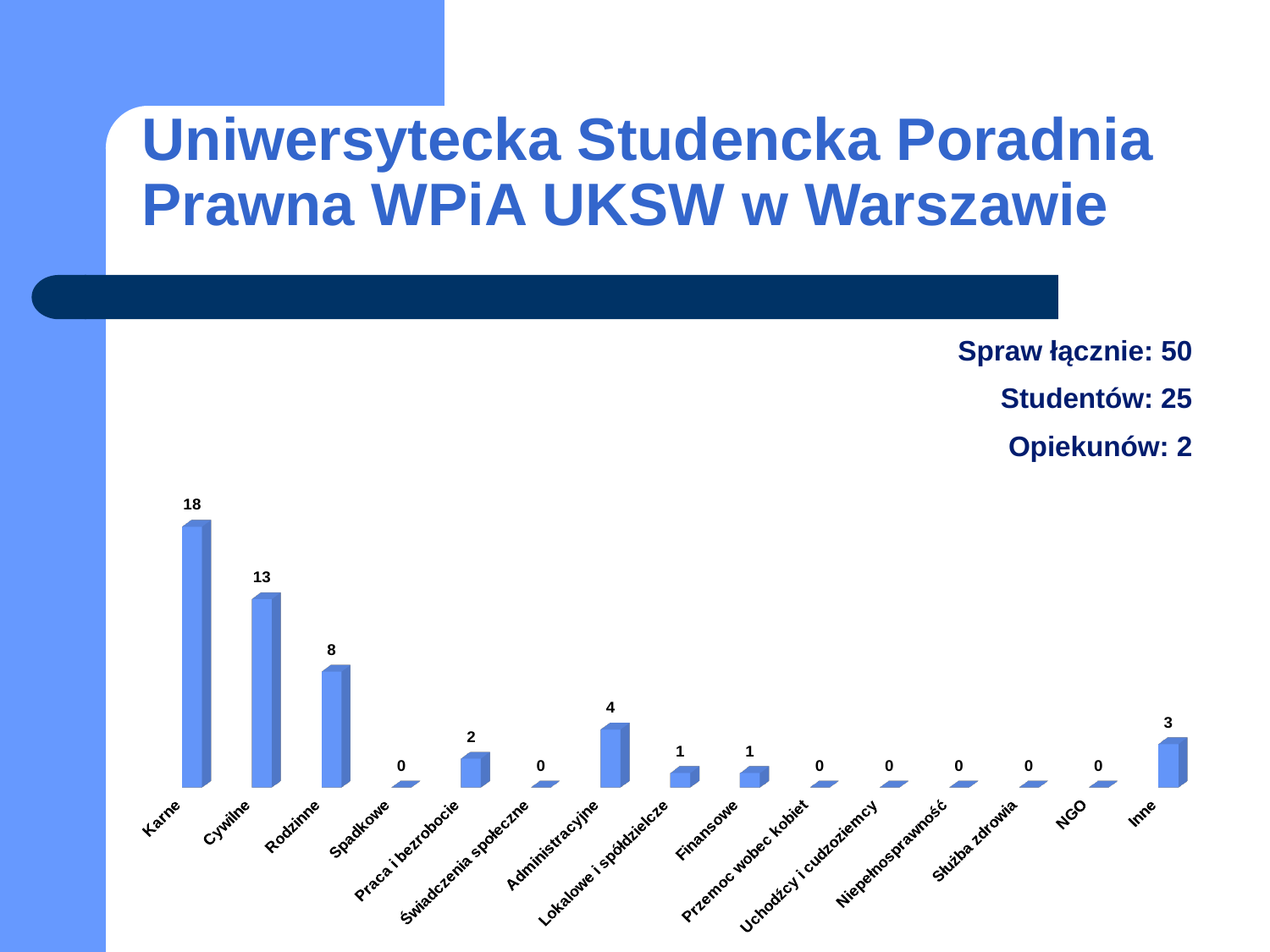
What is the value for Karne? 18 Which category has the highest value? Karne What is the value for Cywilne? 13 What is the difference between the values for Karne and Cywilne? 5 Which is larger, the value for Praca i bezrobocie or the value for Inne? Inne What is the value for Administracyjne? 4 What is the value for Lokalowe i spółdzielcze? 1 How many categories have a value of 0? 7 How many categories are shown on the x axis? 15 What is the difference between the values for Rodzinne and Administracyjne? 4 What is the value for Inne? 3 What kind of chart is shown on the slide? Bar chart